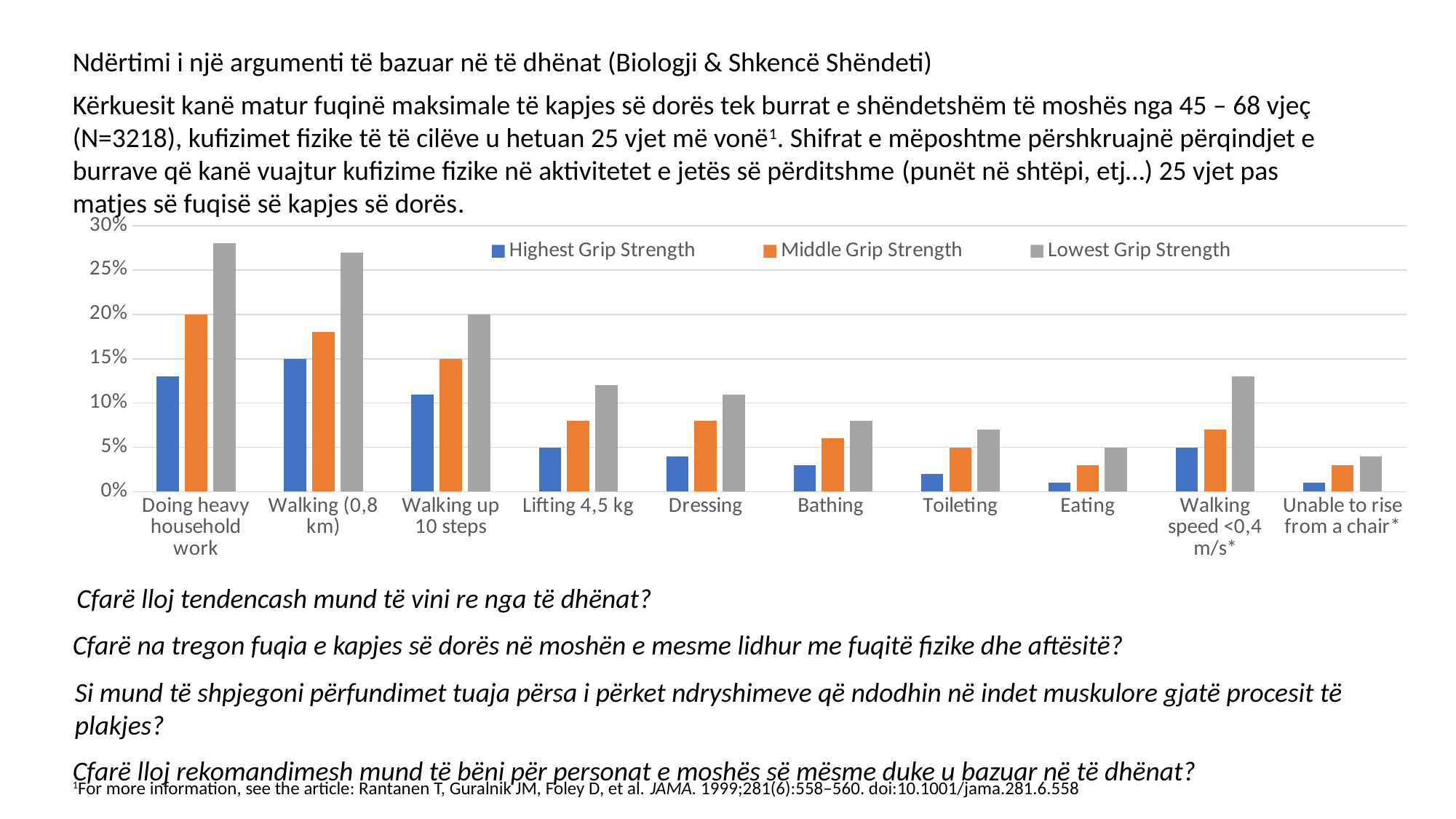
For Dressing, which is larger: the Highest Grip Strength value or the Lowest Grip Strength value? Lowest Grip Strength Which category has the tallest bar in the chart? Doing heavy household work Is the Highest Grip Strength value for Eating greater or less than 5%? less What is the Highest Grip Strength value for Walking (0,8 km)? 15% Is the Lowest Grip Strength value for Walking speed <0,4 m/s* greater or less than 10%? greater What is the Middle Grip Strength value for Doing heavy household work? 20% How many activity categories are shown on the x axis? 10 How many series does the legend list? 3 Is the Lowest Grip Strength value for Doing heavy household work greater or less than 25%? greater What kind of chart is shown on the slide? bar chart What colour are the Lowest Grip Strength bars? gray What is the Lowest Grip Strength value for Walking up 10 steps? 20%